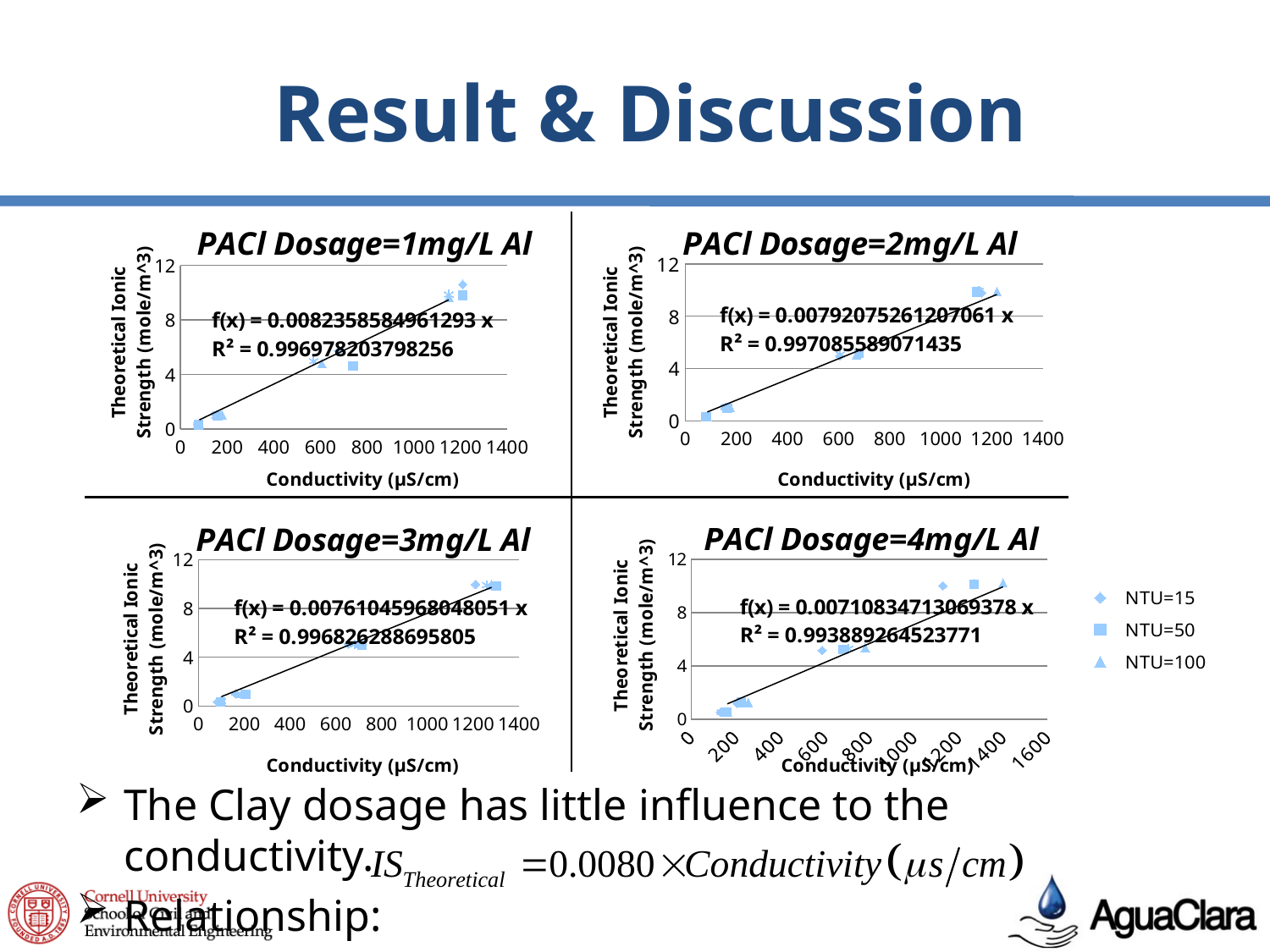
In the PACl Dosage=4mg/L Al chart, what is the slope coefficient in the trendline equation? 0.00710834713069378 Which chart has the higher R² value, PACl Dosage=2mg/L Al or PACl Dosage=4mg/L Al? PACl Dosage=2mg/L Al In the PACl Dosage=1mg/L Al chart, is the highest plotted ionic strength value greater or less than 8? greater In the PACl Dosage=2mg/L Al chart, what is the trendline equation? f(x) = 0.00792075261207061 x In the PACl Dosage=3mg/L Al chart, does theoretical ionic strength rise or fall as conductivity increases? rise What are the three series named in the legend? NTU=15, NTU=50, NTU=100 In the PACl Dosage=1mg/L Al chart, what is the R² value of the trendline? 0.996978203798256 What kind of chart is the PACl Dosage=1mg/L Al chart? scatter chart Which of the four charts has the lowest R² value? PACl Dosage=4mg/L Al How many charts are shown on the slide? 4 How many series does the legend list for the charts? 3 In the PACl Dosage=3mg/L Al chart, what is the R² value of the trendline? 0.996826288695805